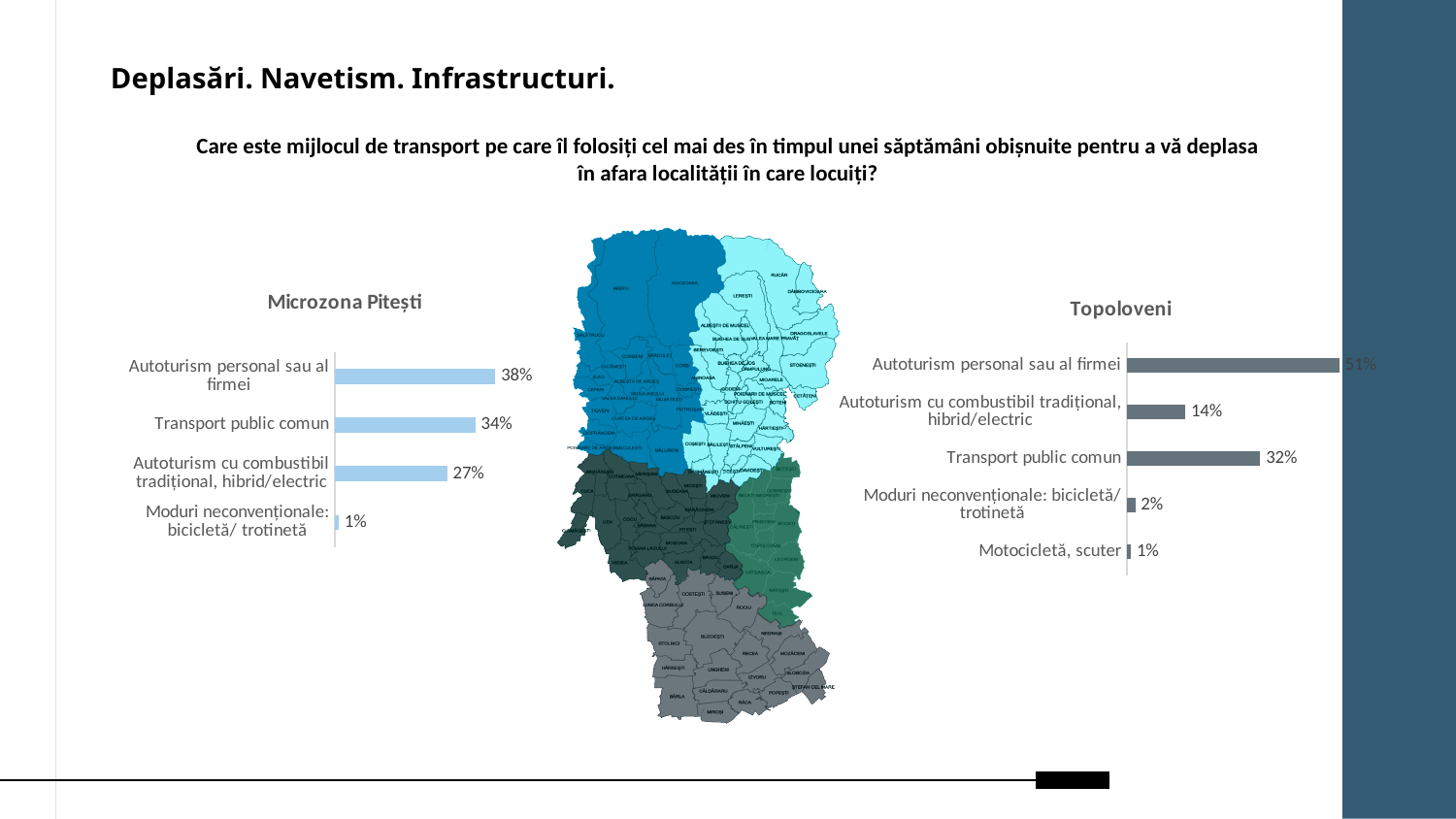
In the Microzona Pitești chart, what is the value for Transport public comun? 34% In the Topoloveni chart, which category has the highest value? Autoturism personal sau al firmei In the Microzona Pitești chart, what is the difference between Autoturism personal sau al firmei and Autoturism cu combustibil tradițional, hibrid/electric? 11% In the Topoloveni chart, which is larger: Transport public comun or Autoturism cu combustibil tradițional, hibrid/electric? Transport public comun How many categories does the Microzona Pitești chart show? 4 In the Topoloveni chart, what is the value for Autoturism cu combustibil tradițional, hibrid/electric? 14% In the Topoloveni chart, what is the value for Autoturism personal sau al firmei? 51% What type of chart is the Topoloveni chart? Bar chart How many categories does the Topoloveni chart show? 5 In the Microzona Pitești chart, which category has the lowest value? Moduri neconvenționale: bicicletă/ trotinetă In the Topoloveni chart, what is the difference between Autoturism personal sau al firmei and Transport public comun? 19% In the Microzona Pitești chart, what is the value for Autoturism personal sau al firmei? 38%